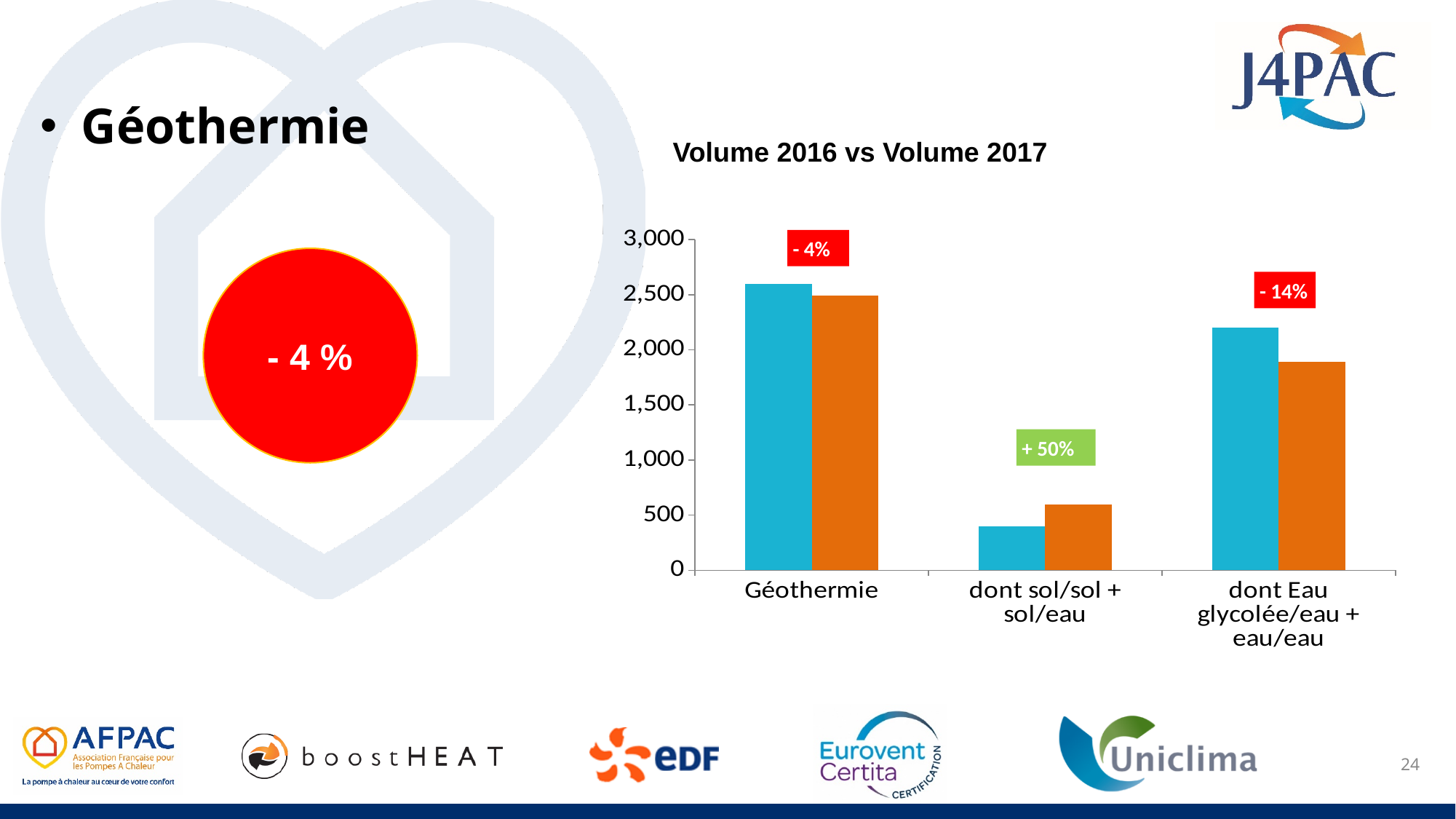
What kind of chart is shown on the slide? bar chart What percentage change is labelled above the 'dont sol/sol + sol/eau' bars? + 50% Is the orange bar for 'dont Eau glycolée/eau + eau/eau' greater or less than 2,000? less What is the title of the chart? Volume 2016 vs Volume 2017 Which category has the shortest bars in the chart? dont sol/sol + sol/eau What percentage change is labelled above the 'dont Eau glycolée/eau + eau/eau' bars? - 14% Is the blue bar for Géothermie greater or less than 2,500? greater Which category has the tallest bars in the chart? Géothermie How many categories are shown on the x axis of the chart? 3 What percentage change is labelled above the Géothermie bars? - 4% Is the blue bar for 'dont sol/sol + sol/eau' greater or less than 500? less For 'dont sol/sol + sol/eau', which bar is taller, the blue one or the orange one? the orange one